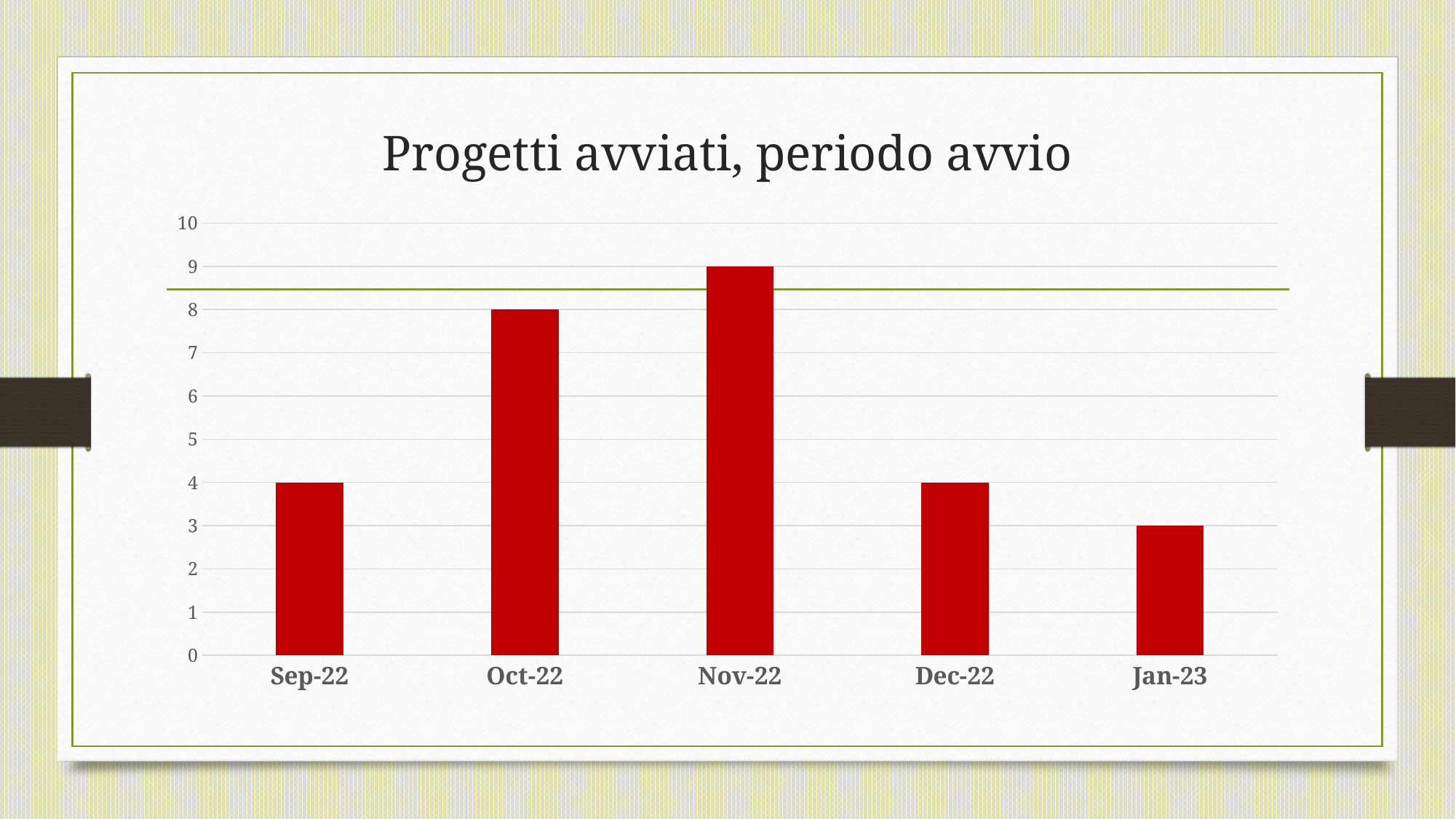
What is the difference between the values for Oct-22 and Dec-22? 4 Which is larger, the value for Sep-22 or the value for Jan-23? Sep-22 What is the value for Jan-23? 3 Which month has the lowest value? Jan-23 What is the title of the chart? Progetti avviati, periodo avvio What kind of chart is shown on the slide? Bar chart What is the value for Sep-22? 4 What is the value for Oct-22? 8 How many months are shown on the x axis? 5 What is the value for Nov-22? 9 Which month has the highest value? Nov-22 What is the difference between the values for Nov-22 and Oct-22? 1